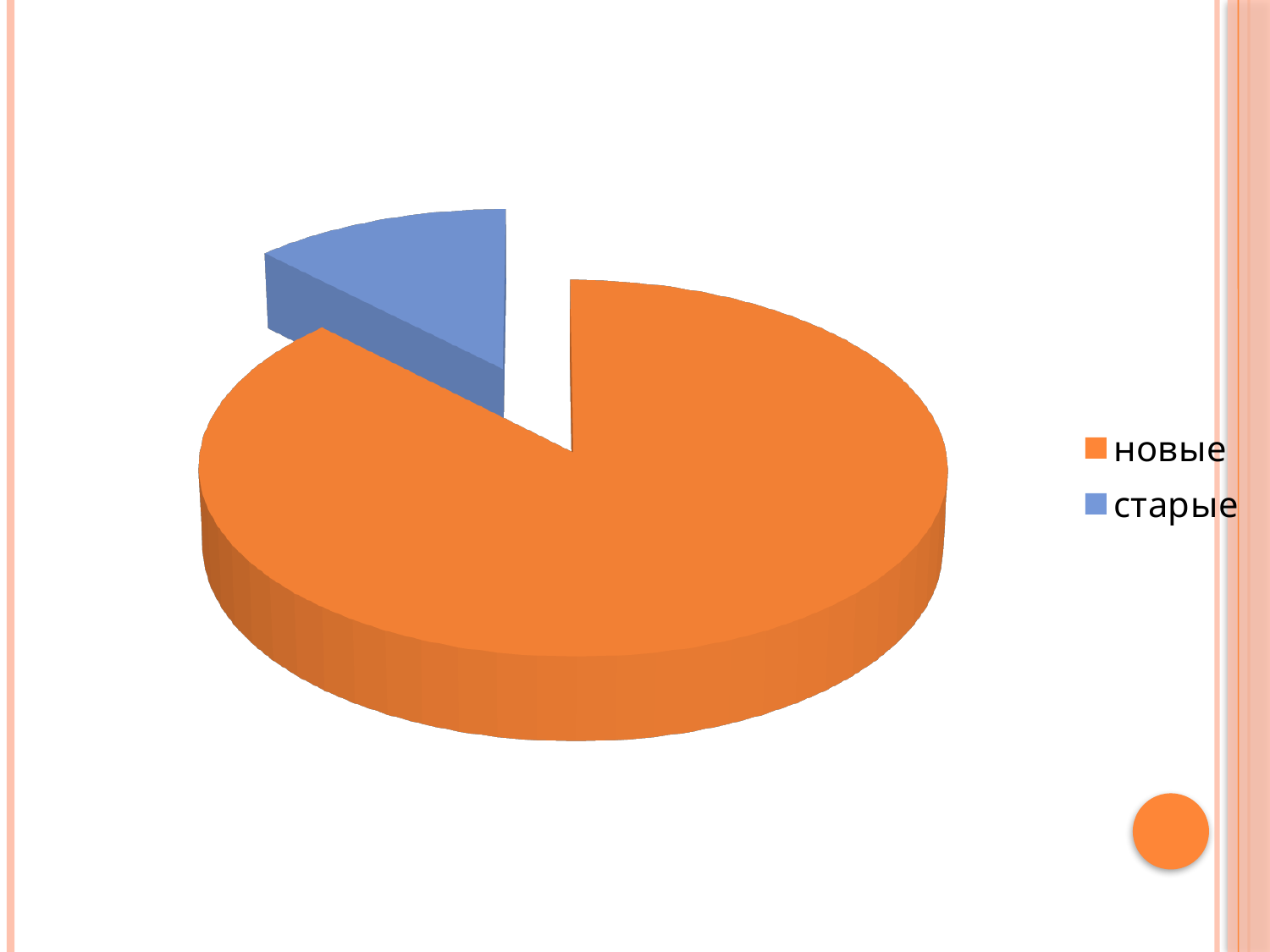
What kind of chart is shown on the slide? pie chart What colour is the slice for новые? orange How many entries does the legend list? 2 How many slices does the pie chart have? 2 Which category has the smallest slice of the pie? старые What colour is the slice for старые? blue Which slice is larger, новые or старые? новые Which category has the largest slice of the pie? новые